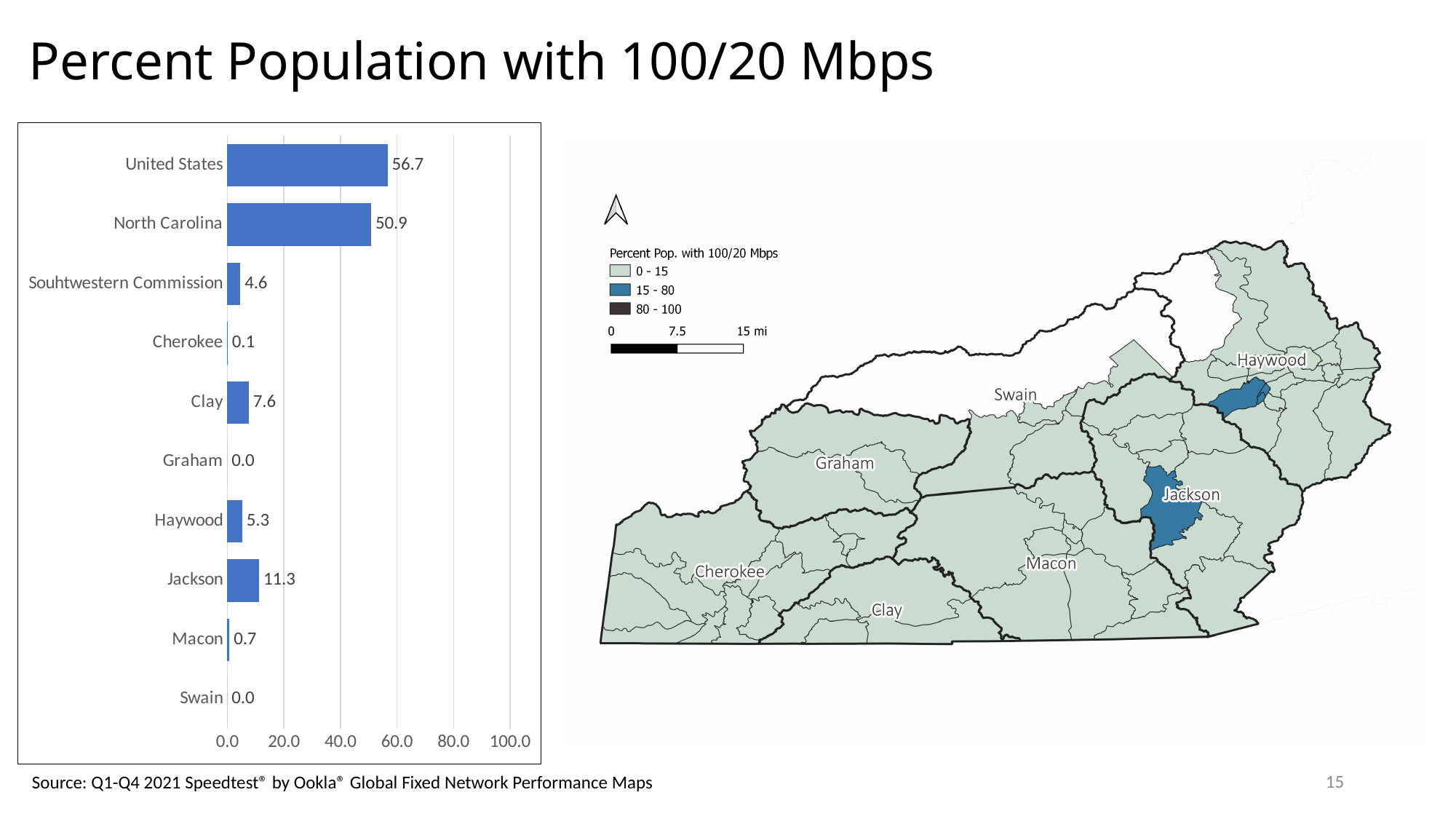
Which is larger in the bar chart, Haywood or Clay? Clay Which category has the highest value in the bar chart? United States What kind of chart is on the left of the slide? bar chart Is the value for North Carolina in the bar chart greater or less than 40.0? greater What is the value for Jackson in the bar chart? 11.3 How many categories are shown in the bar chart? 10 What is the difference between the United States and North Carolina values in the bar chart? 5.8 Which county among the counties shown has the highest value in the bar chart? Jackson What is the value for Clay in the bar chart? 7.6 What is the value for United States in the bar chart? 56.7 Which two counties have a value of 0.0 in the bar chart? Graham and Swain What is the value for Southwestern Commission in the bar chart? 4.6